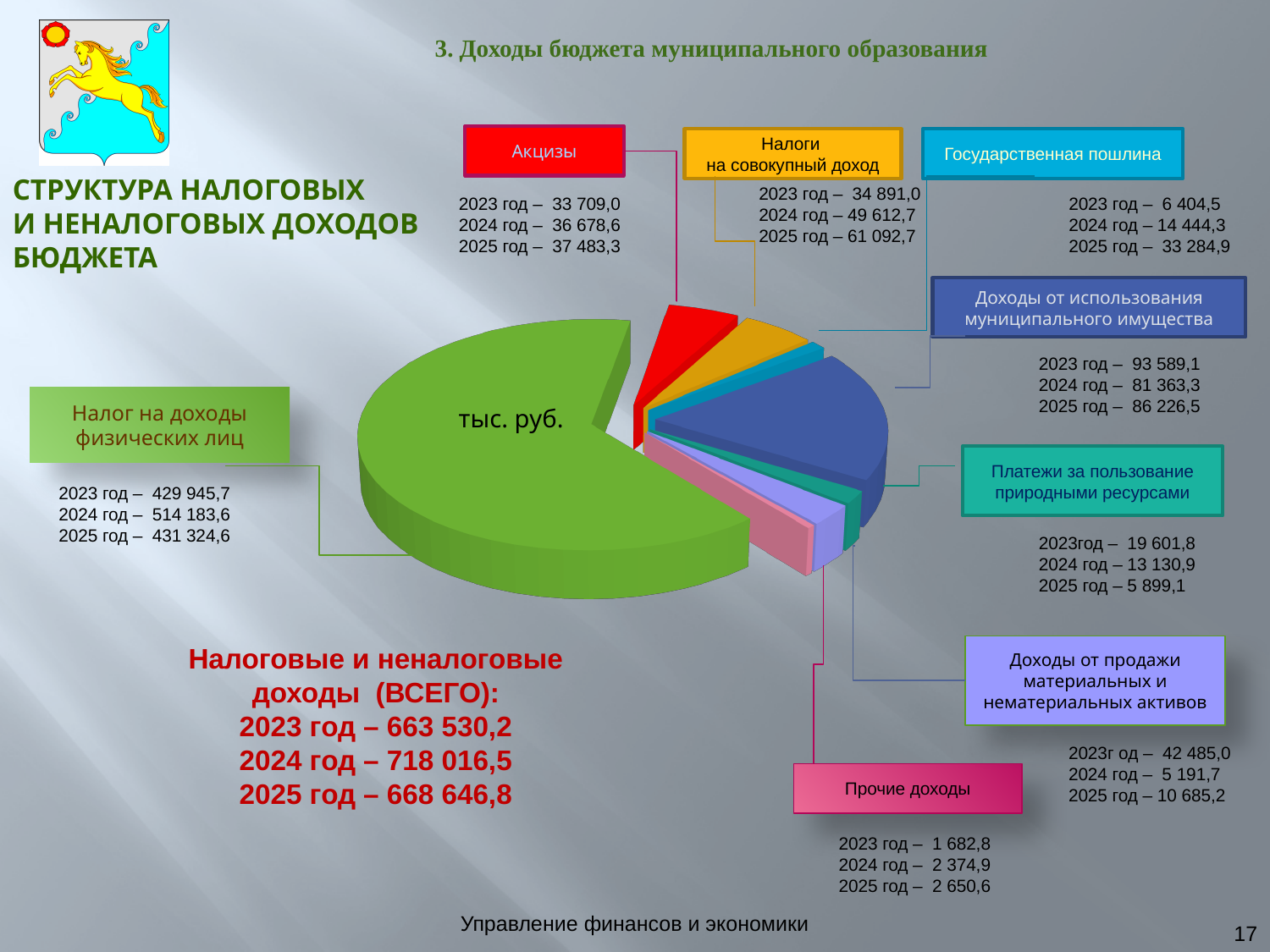
What is the value for Акцизы in 2024? 36 678,6 By how much does the value for Акцизы in 2025 exceed its value in 2023? 3 774,3 What is the value for Прочие доходы in 2025? 2 650,6 What is the total of tax and non-tax revenues (ВСЕГО) for 2024? 718 016,5 What is the value for Доходы от использования муниципального имущества in 2024? 81 363,3 Which is larger in 2025: Акцизы or Государственная пошлина? Акцизы Which revenue category has the largest slice of the pie chart? Налог на доходы физических лиц Which revenue category has the smallest value in 2023? Прочие доходы What is the value for Налоги на совокупный доход in 2025? 61 092,7 How many revenue categories are shown as slices of the pie chart? 8 What is the value for Государственная пошлина in 2023? 6 404,5 What kind of chart is shown on the slide? pie chart